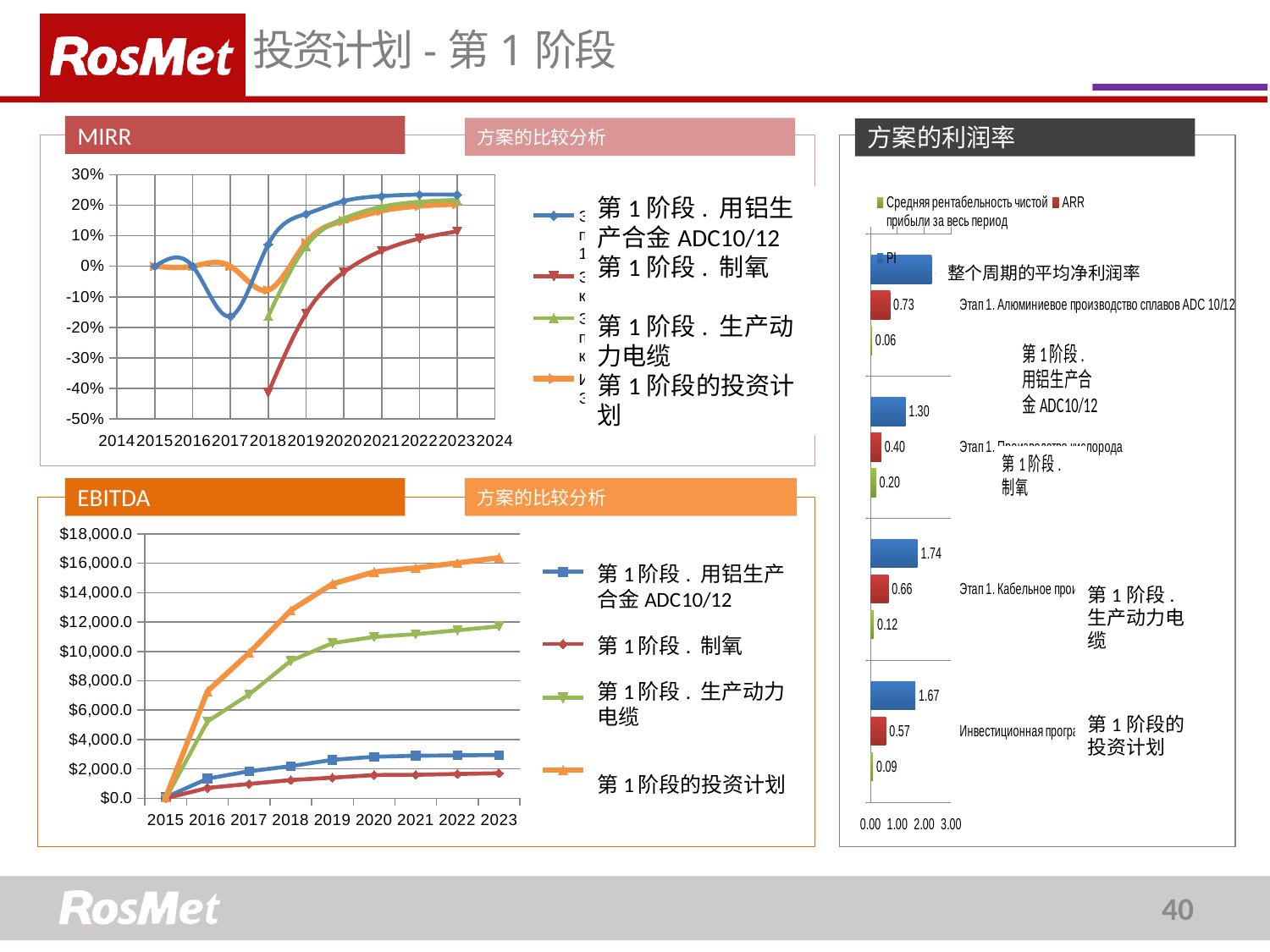
In the EBITDA chart, which series has the lowest value in 2023? 第1阶段.制氧 In the 方案的利润率 chart on the right, what is the PI value for 第1阶段.生产动力电缆? 1.74 In the 方案的利润率 chart on the right, what is the PI value for 第1阶段的投资计划? 1.67 In the EBITDA chart, is the value for 第1阶段.用铝生产合金 ADC10/12 in 2023 greater or less than $2,000.0? greater In the 方案的利润率 chart on the right, what is the ARR value for 第1阶段.制氧? 0.40 How many series does the legend of the 方案的利润率 chart on the right list? 3 How many series does the legend of the MIRR chart list? 4 In the EBITDA chart, which series has the highest value in 2023? 第1阶段的投资计划 In the 方案的利润率 chart on the right, what is the ARR value for 第1阶段.用铝生产合金 ADC10/12? 0.73 What kind of chart is the 方案的利润率 chart on the right? bar chart In the 方案的利润率 chart on the right, what is the difference between the PI of 第1阶段.生产动力电缆 and the PI of 第1阶段的投资计划? 0.07 What kind of chart is the MIRR chart at the top left? line chart